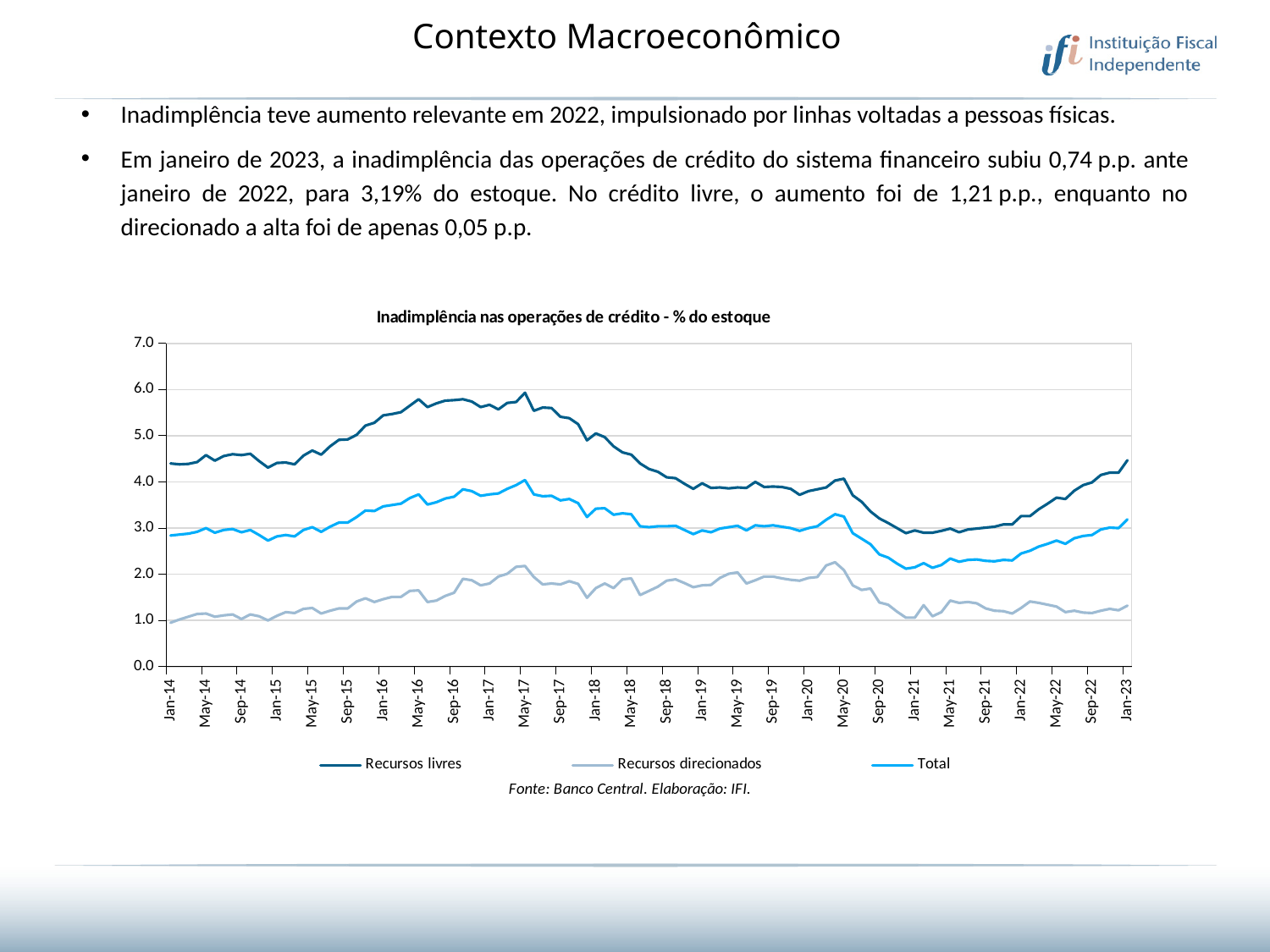
Is the value for Recursos livres at Jan-23 greater or less than 4.0? greater What kind of chart is shown on the slide? Line chart Which series has the lowest values across the whole period shown in the chart? Recursos direcionados Is the value for Recursos livres at May-17 greater or less than 5.0? greater Does the Recursos livres series rise or fall between Jan-22 and Jan-23? Rise Is the value for Recursos direcionados at Jan-21 greater or less than 2.0? less How many series does the chart legend list? 3 Which series has the highest values across the whole period shown in the chart? Recursos livres At Jan-16, which is larger: Recursos livres or Recursos direcionados? Recursos livres What is the title of the chart? Inadimplência nas operações de crédito - % do estoque Which series is plotted with the lightest grey line in the chart? Recursos direcionados